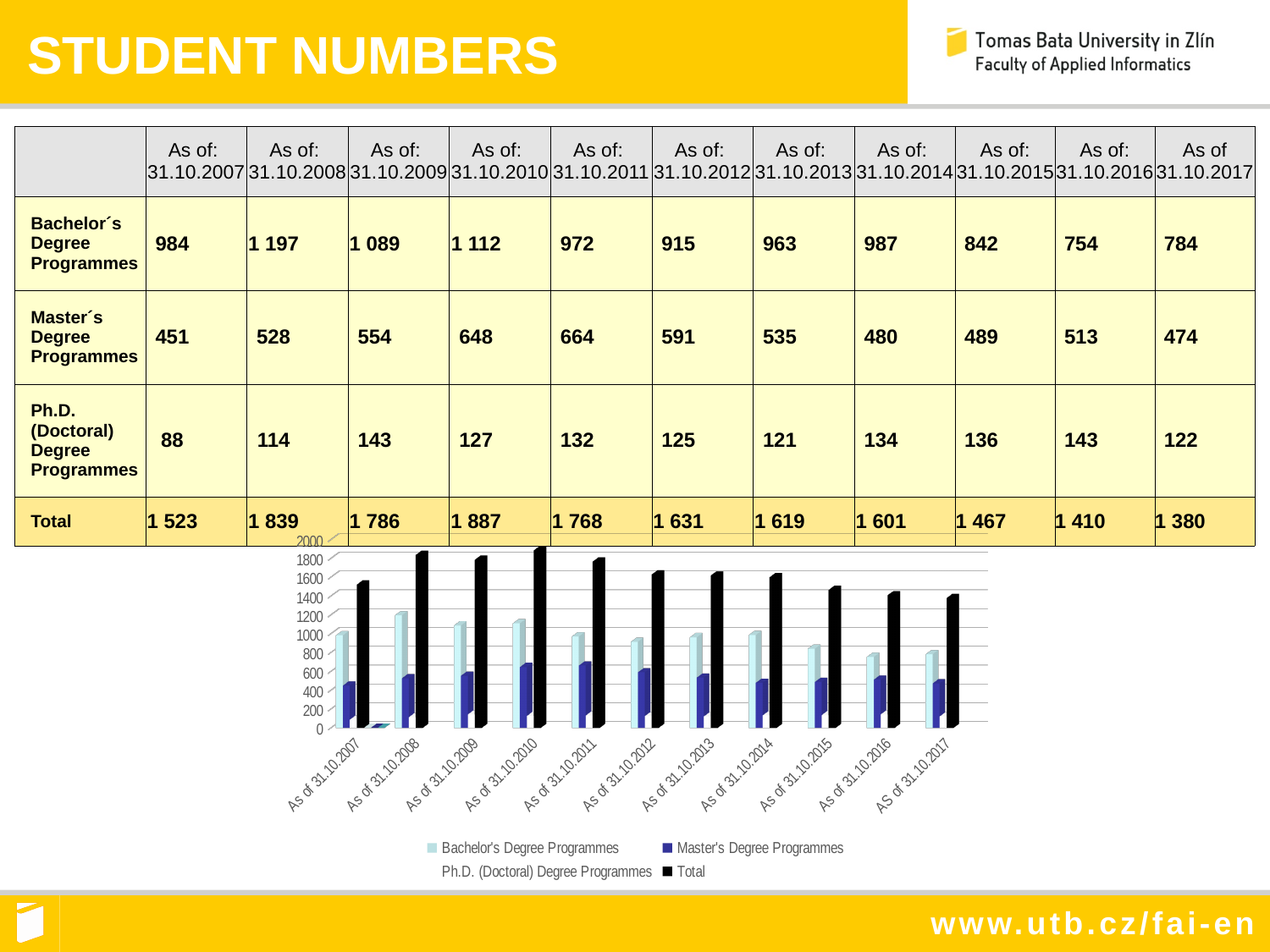
On which date is the Total bar lowest in the chart? As of 31.10.2017 By how much did the Bachelor's Degree Programmes number increase from 31.10.2007 to 31.10.2008? 213 On which date is the Total bar highest in the chart? As of 31.10.2010 How many series does the chart's legend list? 4 Is the Bachelor's Degree Programmes value as of 31.10.2008 greater or less than 1000? greater Which is larger in the chart: the Bachelor's Degree Programmes bar as of 31.10.2008 or as of 31.10.2017? As of 31.10.2008 What kind of chart is shown below the table on the slide? bar chart What is the Total number of students as of 31.10.2007? 1 523 How many dates (categories) are plotted along the x axis of the chart? 11 Do the Total bars rise or fall from 31.10.2010 to 31.10.2017? fall What colour are the Total bars in the chart? black Is the Bachelor's Degree Programmes value as of 31.10.2017 greater or less than 1000? less